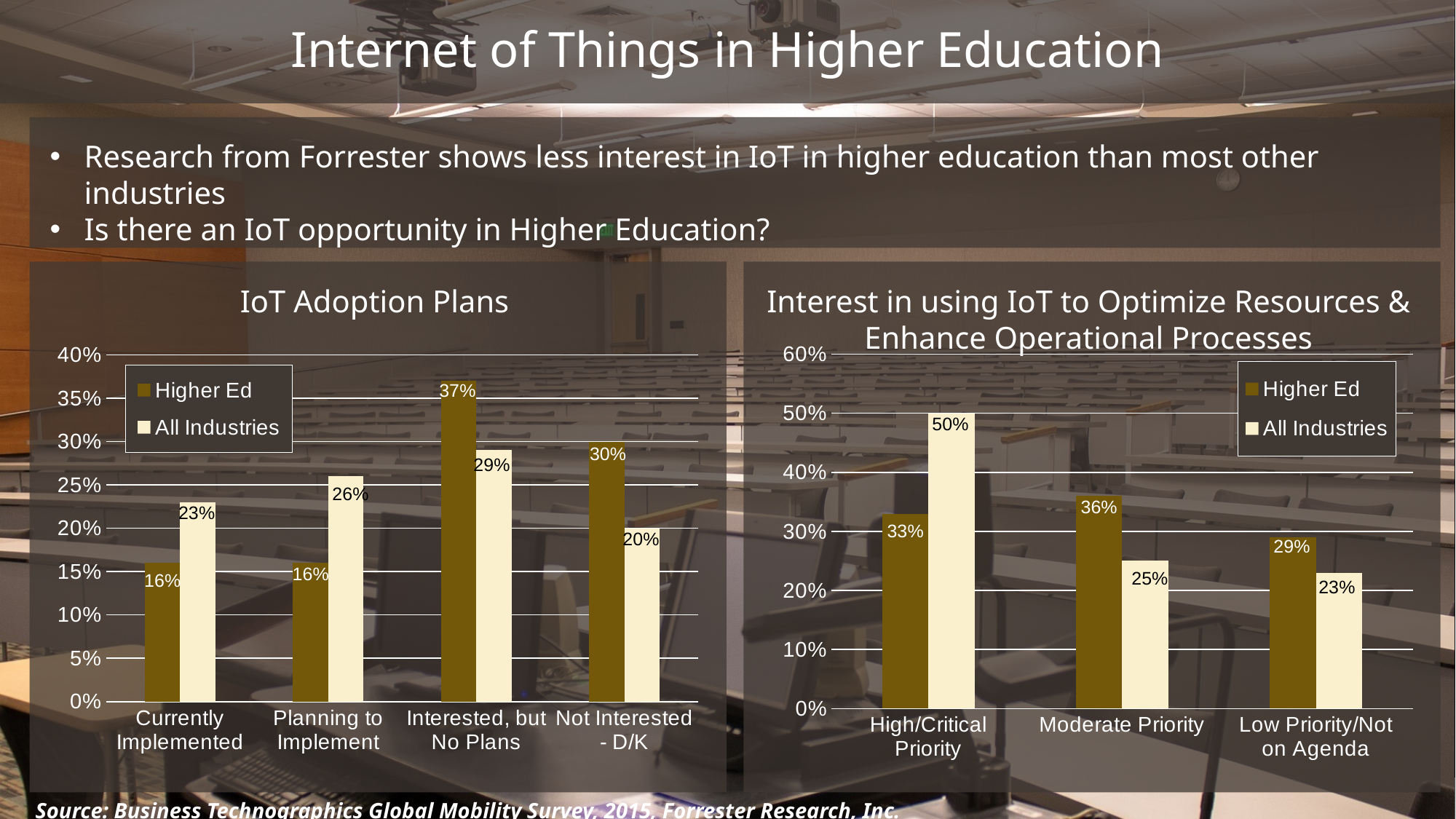
In the 'Interest in using IoT to Optimize Resources & Enhance Operational Processes' chart, what is the difference between the All Industries and Higher Ed values for 'High/Critical Priority'? 17% In the 'Interest in using IoT to Optimize Resources & Enhance Operational Processes' chart, which is larger for 'Moderate Priority': Higher Ed or All Industries? Higher Ed In the 'Interest in using IoT to Optimize Resources & Enhance Operational Processes' chart, which category has the lowest All Industries value? Low Priority/Not on Agenda In the 'IoT Adoption Plans' chart, which category has the highest Higher Ed value? Interested, but No Plans In the 'IoT Adoption Plans' chart, what is the difference between the All Industries and Higher Ed values for 'Planning to Implement'? 10% What kind of chart is the 'IoT Adoption Plans' chart? Bar chart In the 'Interest in using IoT to Optimize Resources & Enhance Operational Processes' chart, what is the All Industries value for 'High/Critical Priority'? 50% In the 'IoT Adoption Plans' chart, what is the All Industries value for 'Currently Implemented'? 23% In the 'IoT Adoption Plans' chart, how many categories are shown on the x axis? 4 How many series does the legend of the 'Interest in using IoT to Optimize Resources & Enhance Operational Processes' chart list? 2 In the 'IoT Adoption Plans' chart, what is the Higher Ed value for 'Interested, but No Plans'? 37% In the 'IoT Adoption Plans' chart, is the Higher Ed value for 'Not Interested - D/K' greater or less than 25%? greater